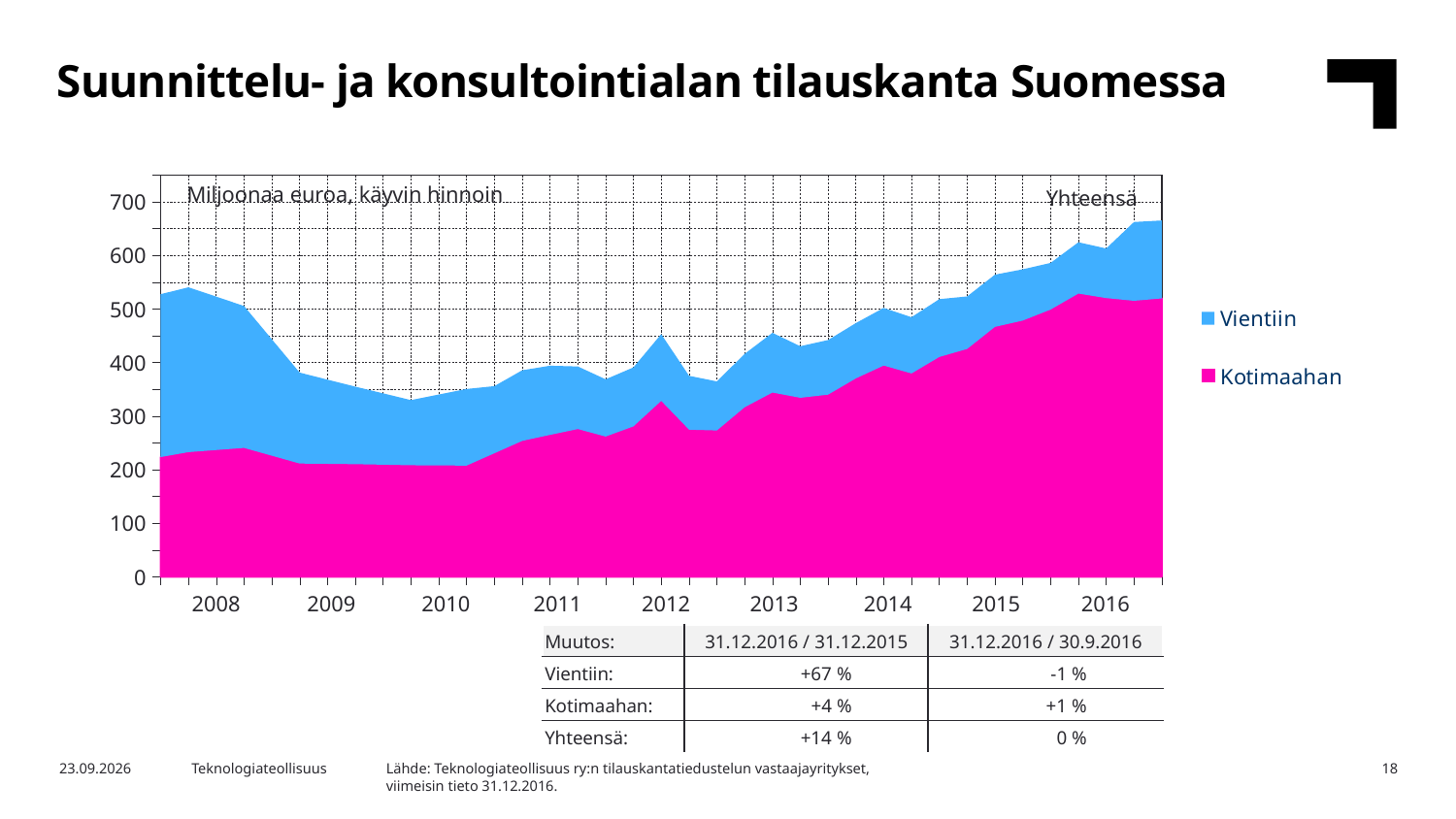
Is the total (Yhteensä) value around 2010 greater or less than 400? less How many series does the legend list? 2 What are the two series named in the legend? Vientiin and Kotimaahan Is the Kotimaahan value at the start of 2008 greater or less than 300? less At the end of 2016, which series is larger, Vientiin or Kotimaahan? Kotimaahan Is the Kotimaahan value at the end of 2016 greater or less than 400? greater Does the Kotimaahan series rise or fall from 2011 to 2016? rise What unit is stated in the label at the top left of the chart area? Miljoonaa euroa, käyvin hinnoin In which year does the total (Yhteensä) reach its highest level? 2016 What kind of chart is shown on the slide? Stacked area chart How many year labels are shown on the x axis? 9